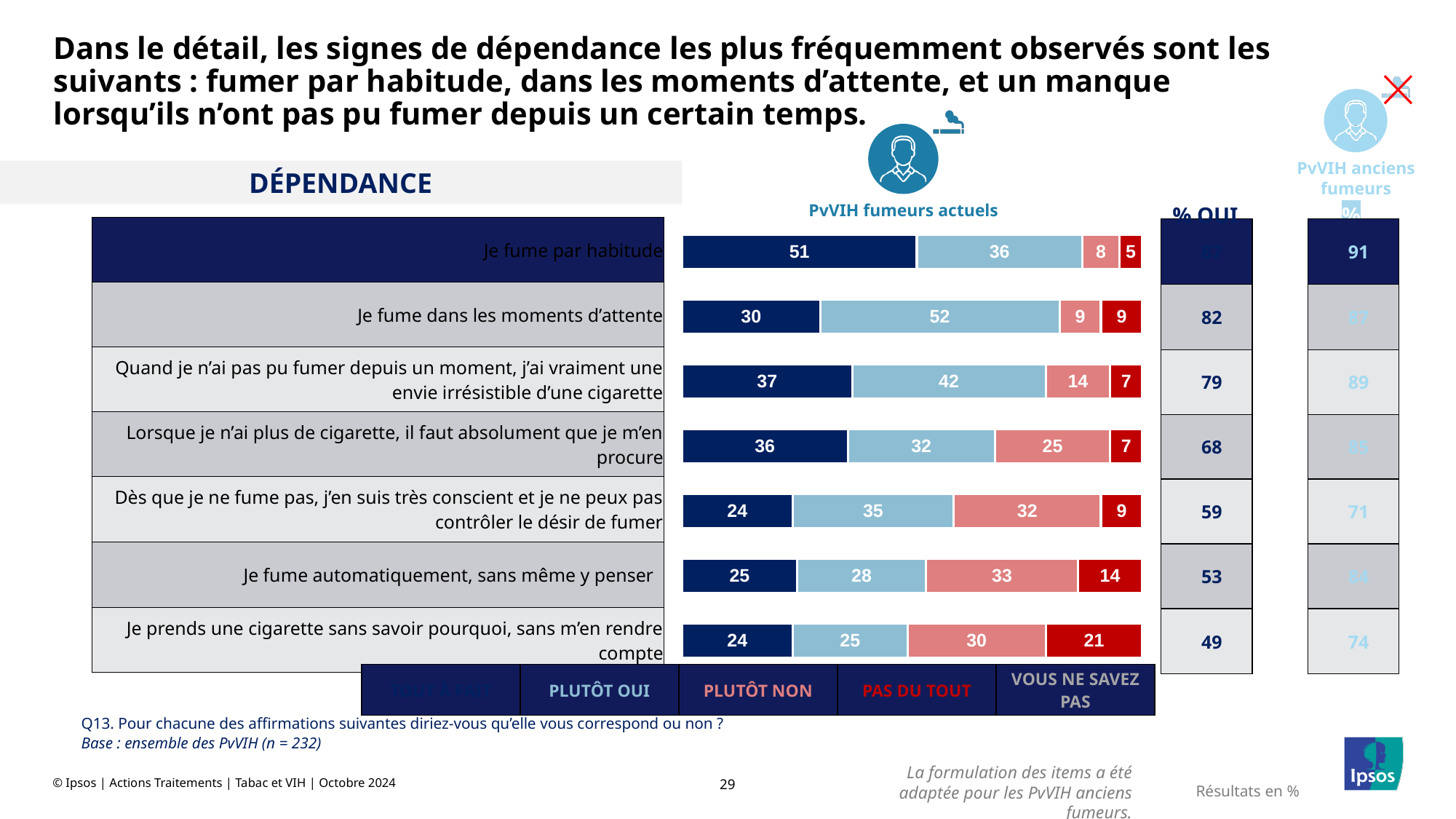
Which has the larger 'Pas du tout' value: 'Je fume automatiquement, sans même y penser' or 'Je fume par habitude'? Je fume automatiquement, sans même y penser What is the difference in % OUI between 'Je fume dans les moments d'attente' and 'Je fume automatiquement, sans même y penser'? 29 What is the % OUI for 'Quand je n'ai pas pu fumer depuis un moment, j'ai vraiment une envie irrésistible d'une cigarette'? 79 What is the value for 'Je fume par habitude' in the PvVIH anciens fumeurs column? 91 What is the 'Tout à fait' value for 'Je fume par habitude' among PvVIH fumeurs actuels? 51 What is the 'Pas du tout' value for 'Je prends une cigarette sans savoir pourquoi, sans m'en rendre compte'? 21 Which item has the highest 'Tout à fait' value? Je fume par habitude How many response categories does the legend list? 5 What kind of chart is used to show the responses? Stacked bar chart What is the 'Plutôt oui' value for 'Je fume dans les moments d'attente'? 52 How many items (statements) are plotted in the chart? 7 Which item has the lowest % OUI? Je prends une cigarette sans savoir pourquoi, sans m'en rendre compte